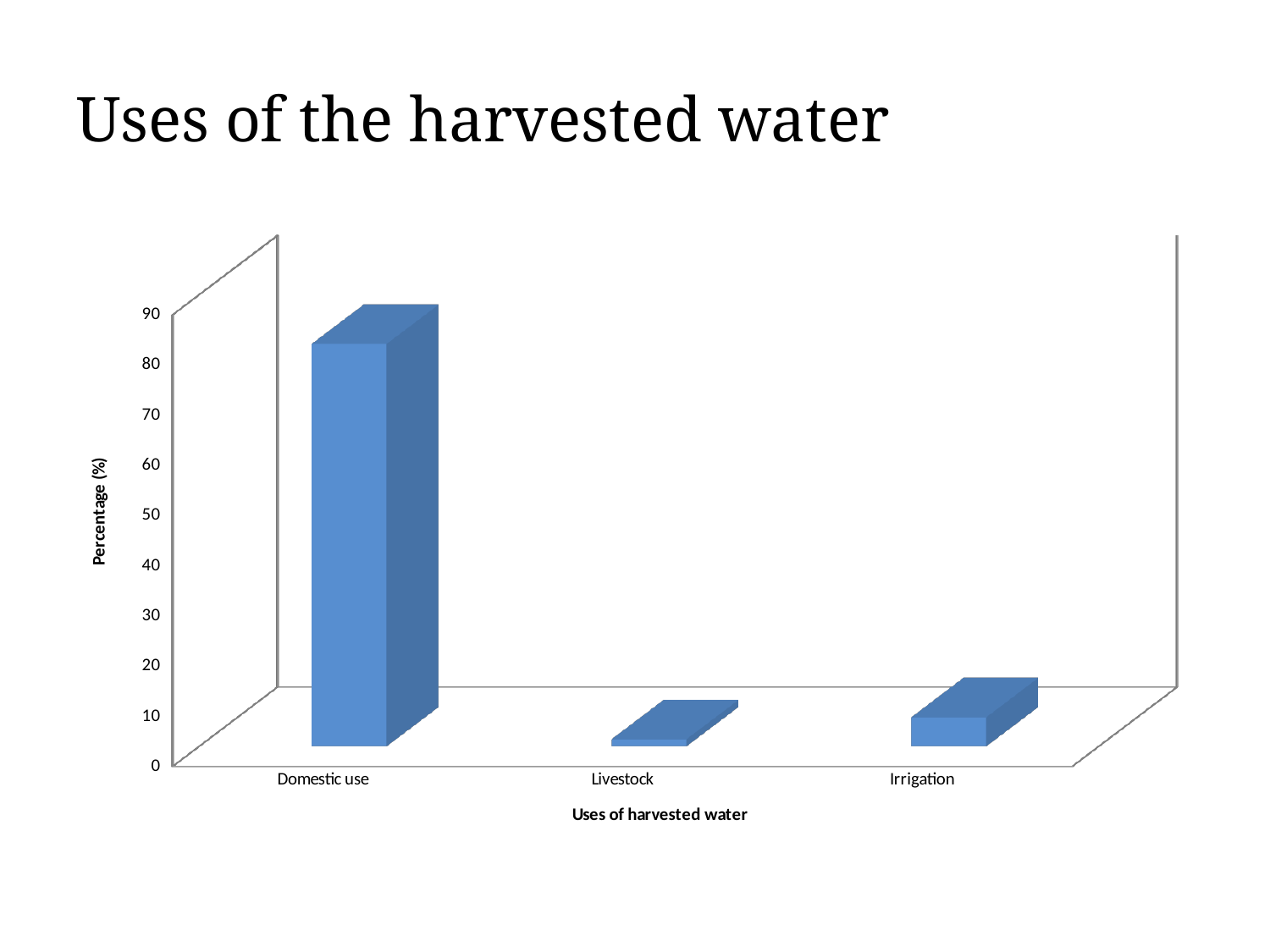
What is the title of the horizontal axis? Uses of harvested water Which is larger, the value for Irrigation or the value for Livestock? Irrigation How many categories are plotted on the x axis? 3 Which use of harvested water has the lowest percentage? Livestock Which is larger, the value for Domestic use or the value for Irrigation? Domestic use Is the value for Livestock greater or less than 10? less Is the value for Domestic use greater or less than 70? greater Is the value for Irrigation greater or less than 20? less Which use of harvested water has the highest percentage? Domestic use What kind of chart is shown on the slide? Bar chart What is the title of the vertical axis? Percentage (%)